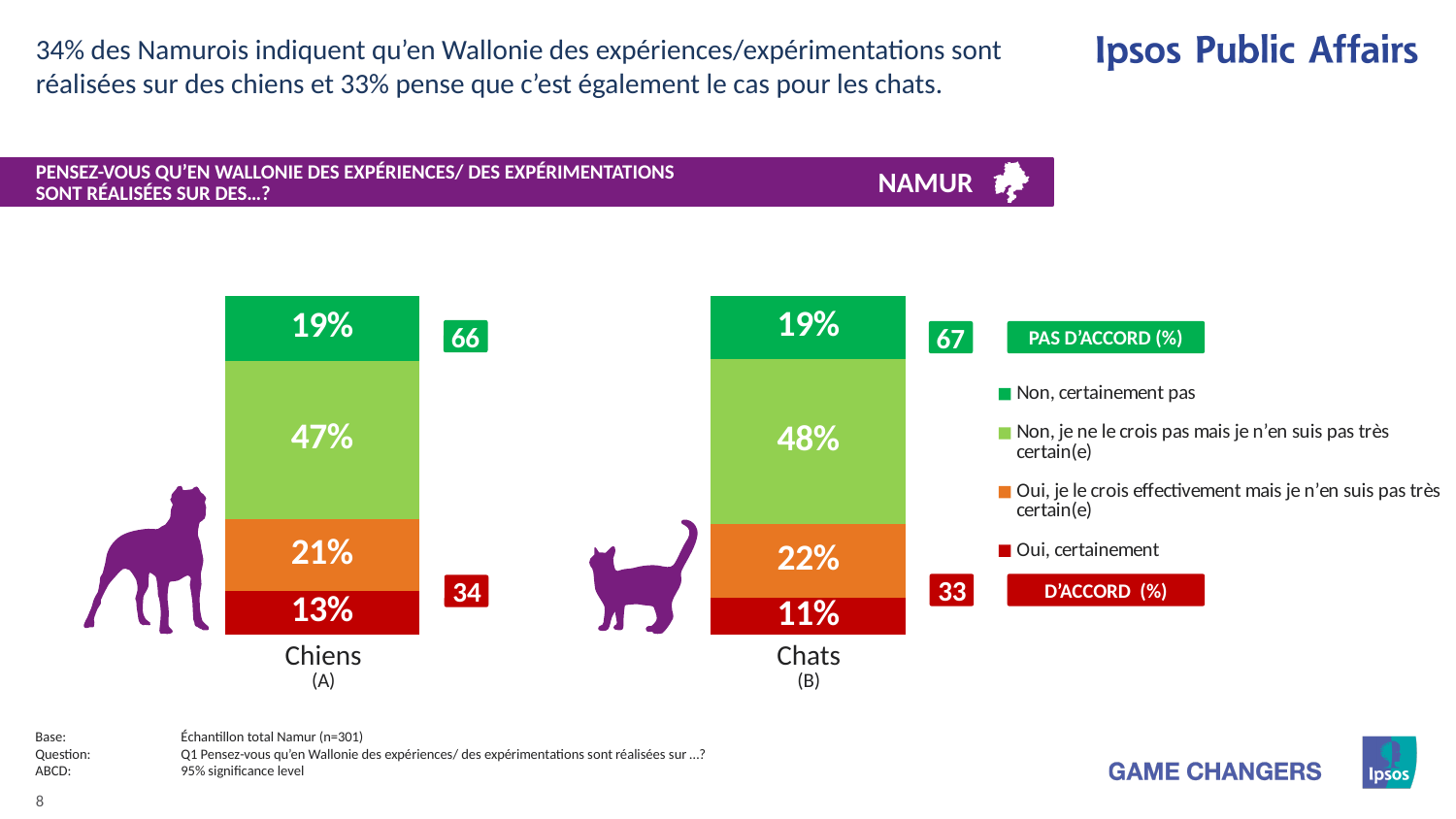
How many categories are shown on the x axis of the chart? 2 What is the value of the "Oui, je le crois effectivement mais je n'en suis pas très certain(e)" segment for Chiens? 21% How many series does the legend list? 4 Which segment is the smallest in the Chats bar? Oui, certainement What is the "D'accord (%)" total shown for Chiens? 34 What is the difference between the "Oui, certainement" values for Chiens and Chats? 2 percentage points What is the "Pas d'accord (%)" total shown for Chats? 67 What percentage of respondents answered "Oui, certainement" for Chats? 11% Is the "Non, certainement pas" value larger for Chiens or for Chats? They are equal (19%) What percentage of respondents answered "Oui, certainement" for Chiens? 13% Which segment is the largest in the Chiens bar? Non, je ne le crois pas mais je n'en suis pas très certain(e) What is the value of the "Non, je ne le crois pas mais je n'en suis pas très certain(e)" segment for Chats? 48%